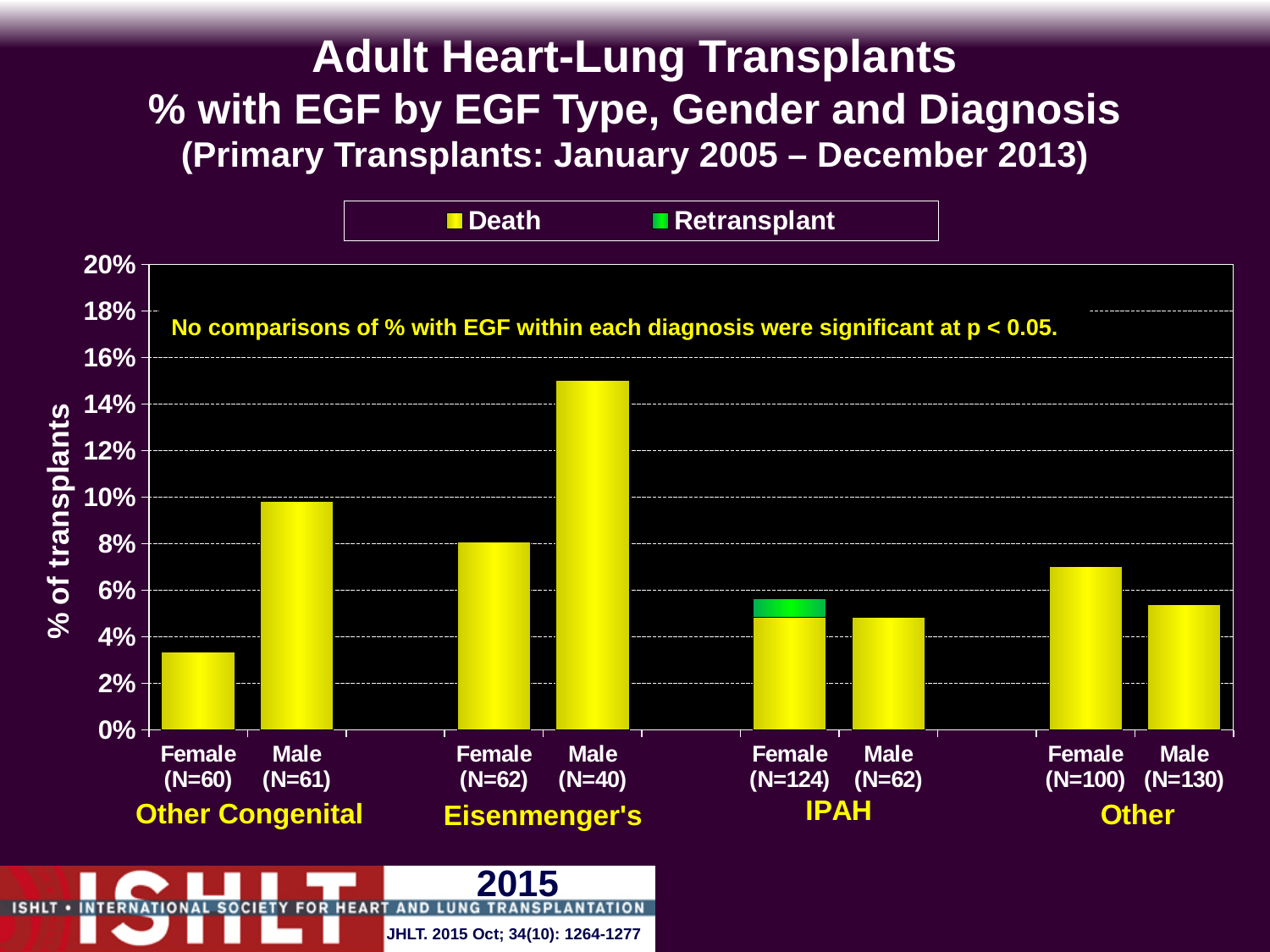
Is the value for Male (N=130) in the Other group greater or less than 6%? less Which bar has the lowest % of transplants with EGF? Female (N=60), Other Congenital In the Other group, which bar is larger, Female (N=100) or Male (N=130)? Female (N=100) How many series does the legend list? 2 What kind of chart is shown on the slide? bar chart Which series is shown in green in the legend? Retransplant How many bars are plotted in the chart? 8 In the Eisenmenger's group, which bar is larger, Female (N=62) or Male (N=40)? Male (N=40) Is the value for Female (N=60) in the Other Congenital group greater or less than 4%? less Which bar has the highest % of transplants with EGF? Male (N=40), Eisenmenger's Is the value for Male (N=40) in the Eisenmenger's group greater or less than 14%? greater